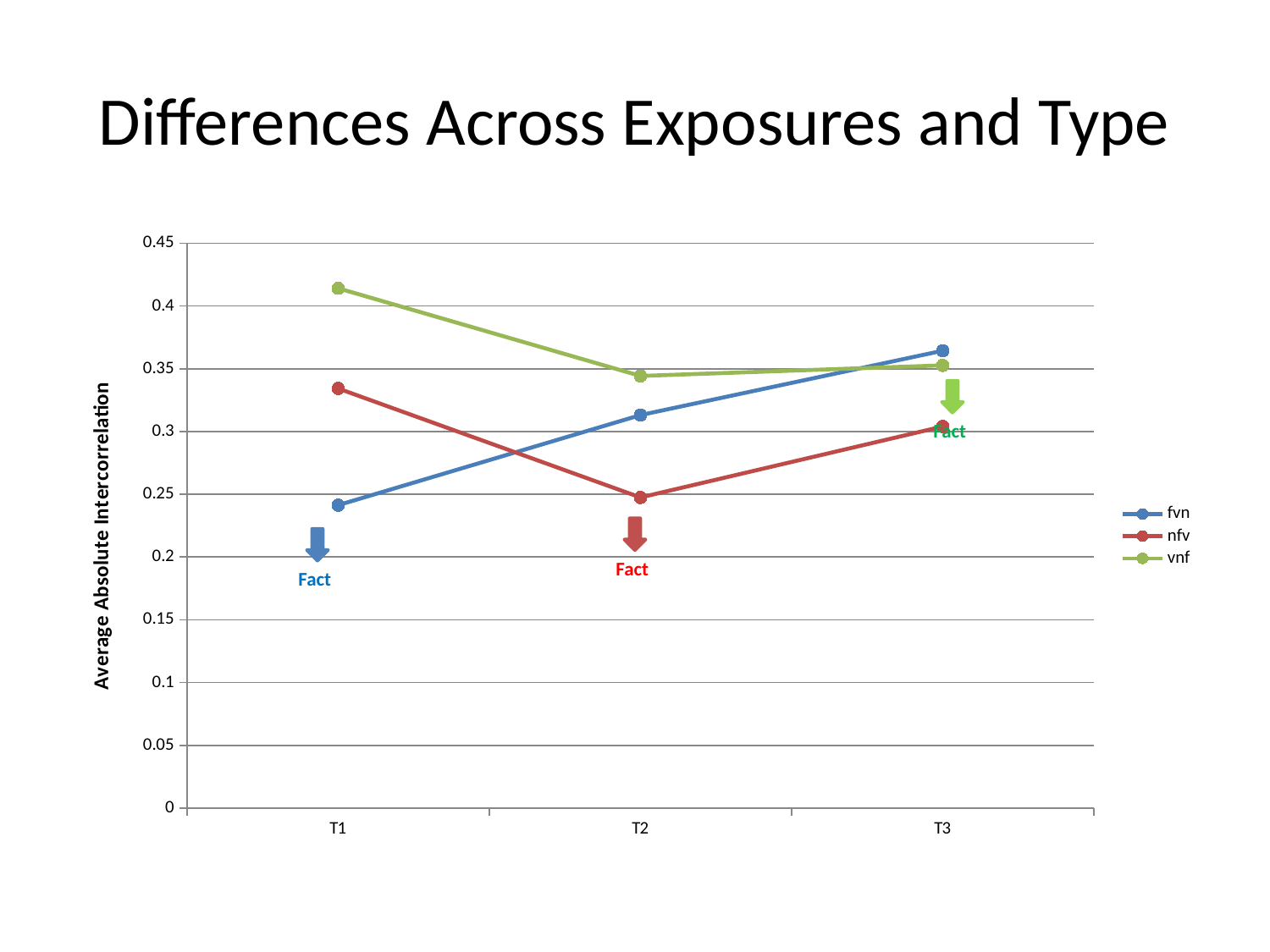
Is the value for fvn at T3 greater or less than 0.35? greater What kind of chart is shown on the slide? line chart Which series has the lowest value at T2? nfv Which series has the lowest value at T1? fvn Does the fvn series rise or fall from T1 to T3? rise At T2, which series has the larger value, fvn or nfv? fvn Is the value for vnf at T1 greater or less than 0.4? greater What is the label of the y axis? Average Absolute Intercorrelation Is the value for nfv at T2 greater or less than 0.3? less How many series does the legend list? 3 Which series has the highest value at T1? vnf How many points are plotted along the x axis for each series? 3